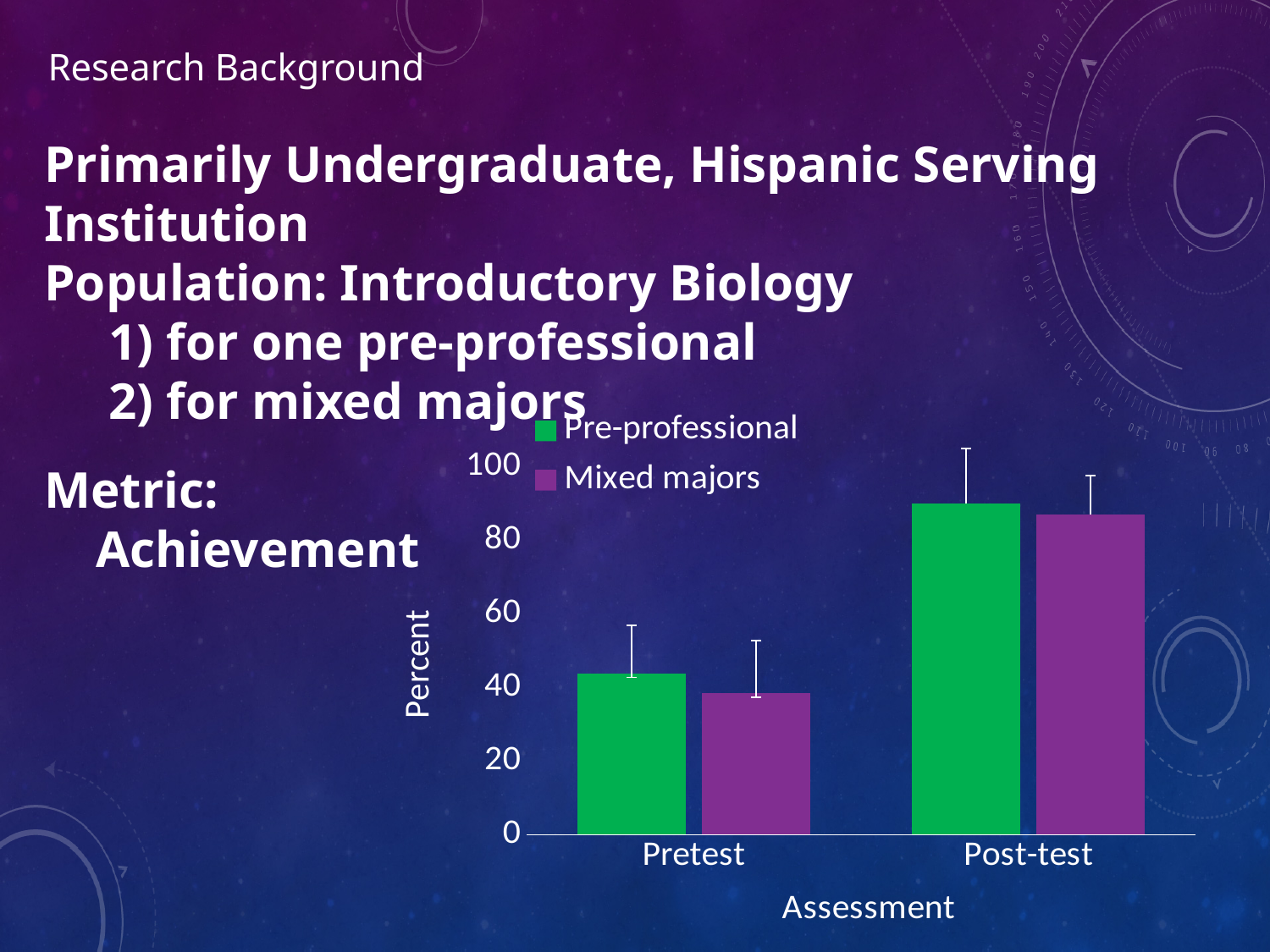
For the Mixed majors series, which assessment has the lower value? Pretest Which series is shown in green in the chart? Pre-professional What kind of chart is shown on the slide? bar chart Do the values for both series rise or fall from Pretest to Post-test? rise What is the title of the vertical axis of the chart? Percent How many assessment categories are shown on the x axis of the chart? 2 Is the Pre-professional value for Post-test greater or less than 80? greater Is the Pre-professional value for Pretest greater or less than 60? less Is the Mixed majors value for Post-test greater or less than 100? less How many series does the chart's legend list? 2 For the Pre-professional series, which assessment has the higher value, Pretest or Post-test? Post-test